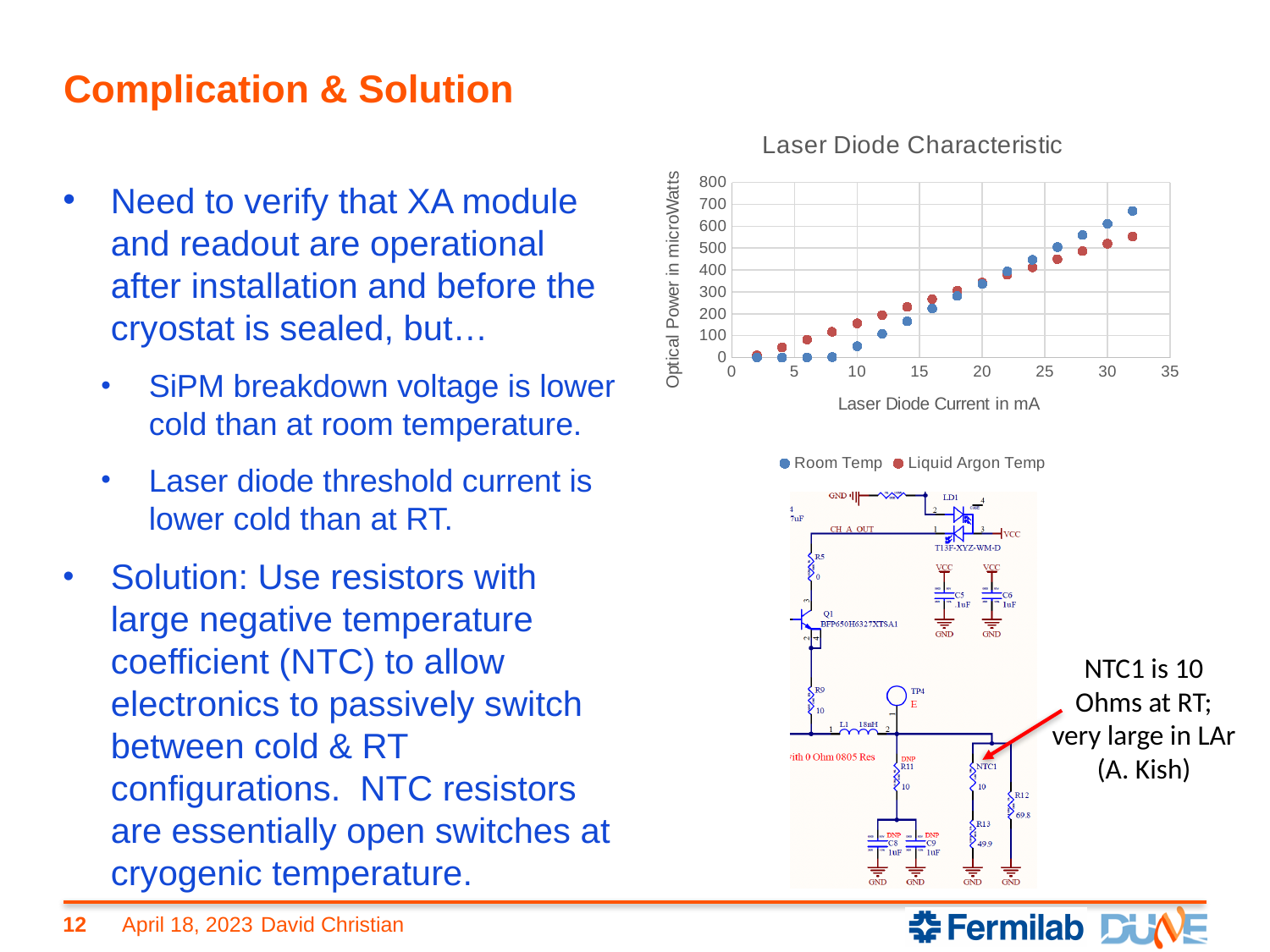
In the Laser Diode Characteristic chart, is the Room Temp optical power at 32 mA greater or less than 600 microWatts? greater What type of chart is the Laser Diode Characteristic chart? Scatter chart How many series does the legend of the Laser Diode Characteristic chart list? 2 In the Laser Diode Characteristic chart, is the Room Temp optical power at 10 mA greater or less than 100 microWatts? less In the Laser Diode Characteristic chart, which series has the higher optical power at 32 mA, Room Temp or Liquid Argon Temp? Room Temp In the Laser Diode Characteristic chart, is the Liquid Argon Temp optical power at 10 mA greater or less than 100 microWatts? greater In the Laser Diode Characteristic chart, does optical power rise or fall as laser diode current increases? Rise What colour are the Room Temp points in the Laser Diode Characteristic chart? Blue What is the label of the x axis of the Laser Diode Characteristic chart? Laser Diode Current in mA In the Laser Diode Characteristic chart, which series has the higher optical power at 10 mA, Room Temp or Liquid Argon Temp? Liquid Argon Temp